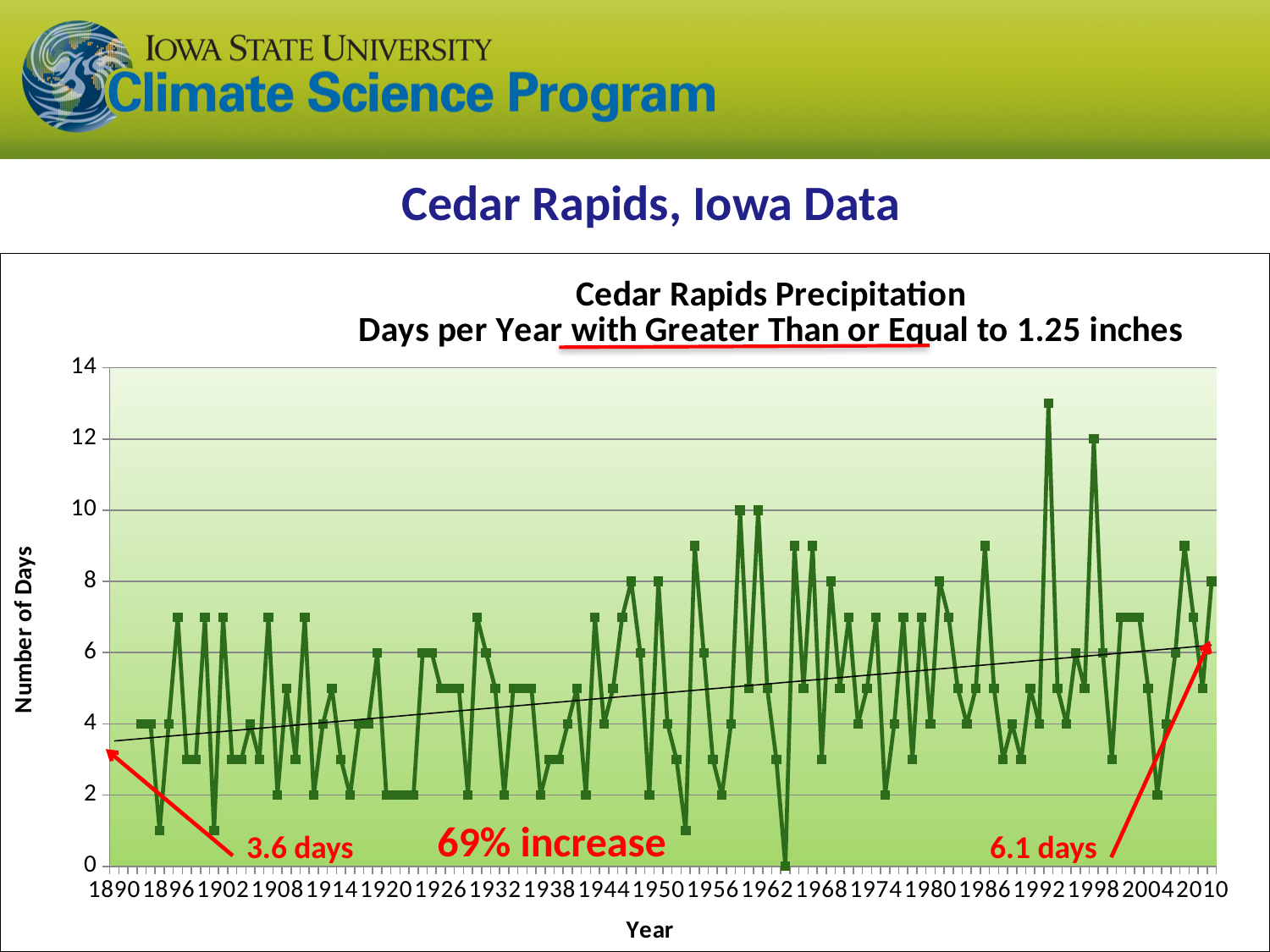
What percentage increase is annotated on the chart? 69% increase What value is annotated at the start of the trend line (around 1890)? 3.6 days Is the lowest value plotted on the chart greater or less than 2? less What kind of chart is shown on the slide? line chart Is the value for 1998 greater or less than 10? greater What value is annotated at the end of the trend line (around 2010)? 6.1 days What is the label on the vertical axis of the chart? Number of Days Which annotated trend-line value is larger, the one at the start (3.6 days) or the one at the end (6.1 days)? 6.1 days Does the trend line rise or fall from 1890 to 2010? rises What is the title of the chart? Cedar Rapids Precipitation Days per Year with Greater Than or Equal to 1.25 inches Is the highest value plotted on the chart greater or less than 12? greater What is the difference between the annotated end value (6.1 days) and start value (3.6 days) of the trend line? 2.5 days